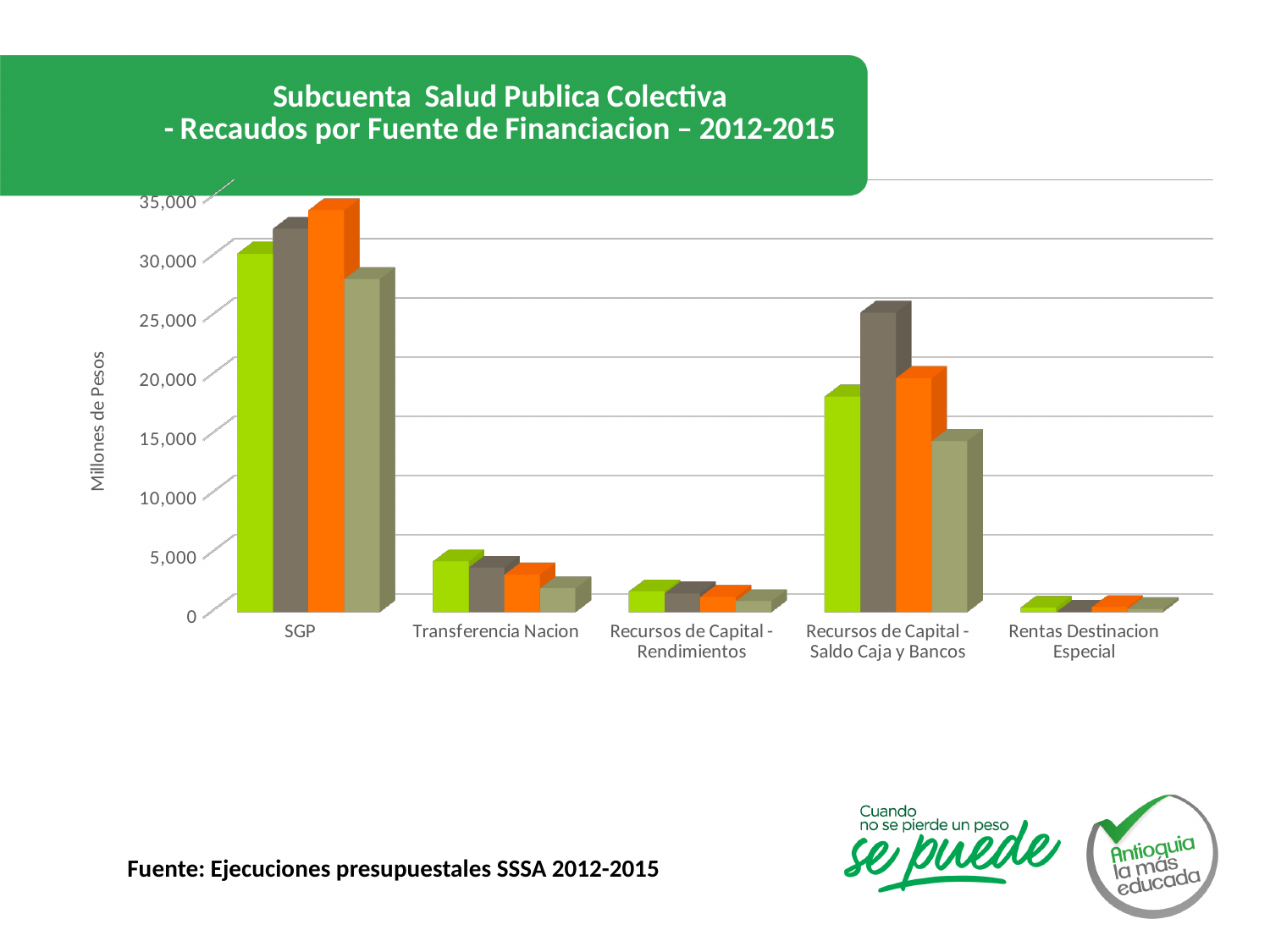
What is the title of the chart? Subcuenta Salud Publica Colectiva - Recaudos por Fuente de Financiacion – 2012-2015 Is the value of the green bar for Recursos de Capital - Saldo Caja y Bancos greater or less than 15,000? greater Which category has the smallest bars in the chart? Rentas Destinacion Especial How many categories are shown on the x axis of the chart? 5 Is the value of the green bar for SGP greater or less than 25,000? greater Which category has the tallest bars in the chart? SGP What is the label of the vertical axis of the chart? Millones de Pesos Is the value of the orange bar for SGP greater or less than 30,000? greater Which category has larger bars, Transferencia Nacion or Recursos de Capital - Saldo Caja y Bancos? Recursos de Capital - Saldo Caja y Bancos What kind of chart is shown on the slide? bar chart